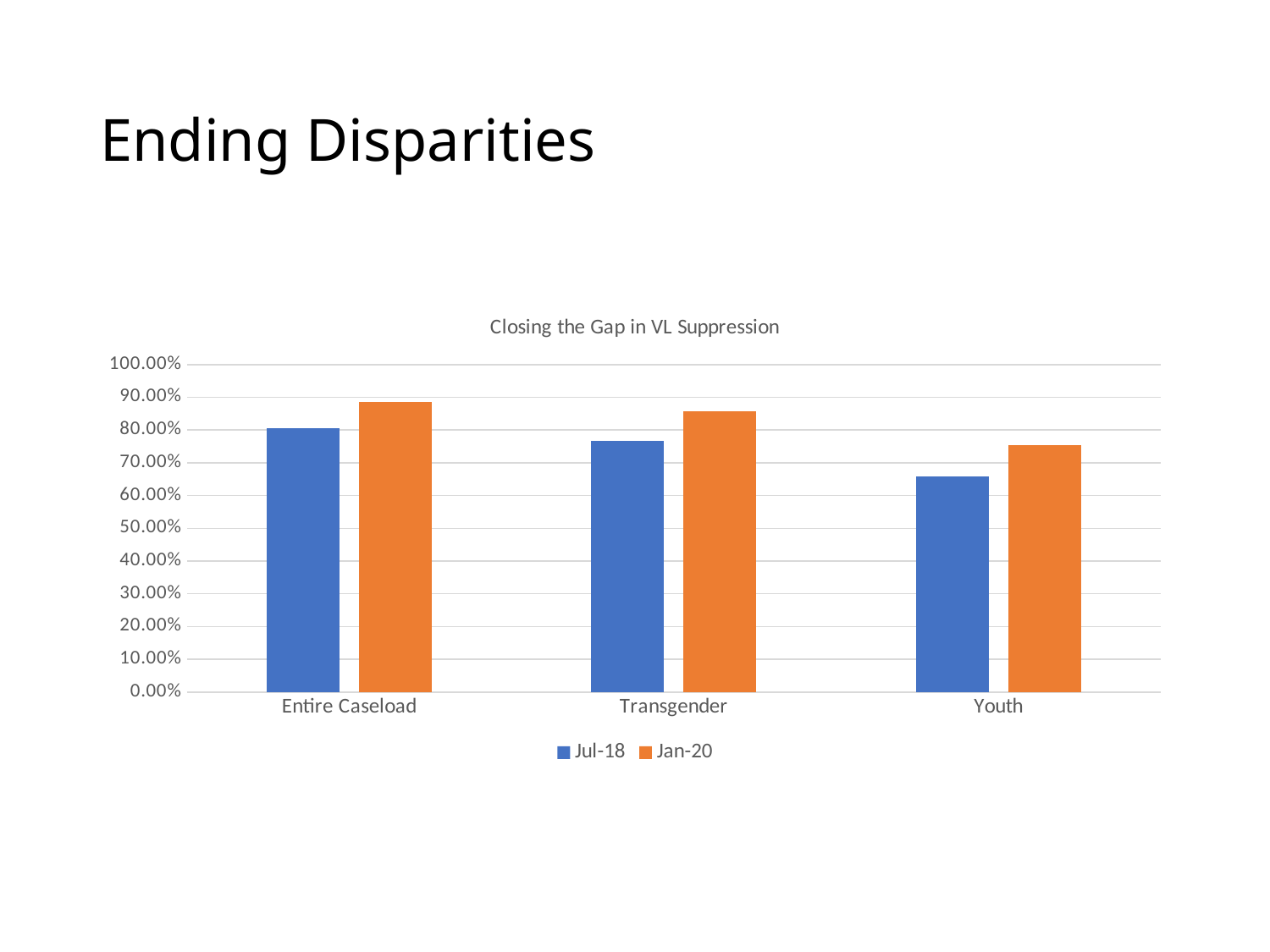
Is the Jan-20 value for Youth greater or less than 80.00%? less What kind of chart is shown on the slide? bar chart Which category has the highest Jan-20 value? Entire Caseload What is the title of the chart? Closing the Gap in VL Suppression How many series does the legend list? 2 Is the Jul-18 value for Youth greater or less than 70.00%? less For Transgender, which is larger: the Jul-18 value or the Jan-20 value? Jan-20 For Youth, which is larger: the Jul-18 value or the Jan-20 value? Jan-20 How many categories are shown on the x axis? 3 Which series is shown in orange? Jan-20 Which category has the lowest Jul-18 value? Youth Is the Jan-20 value for Transgender greater or less than 80.00%? greater